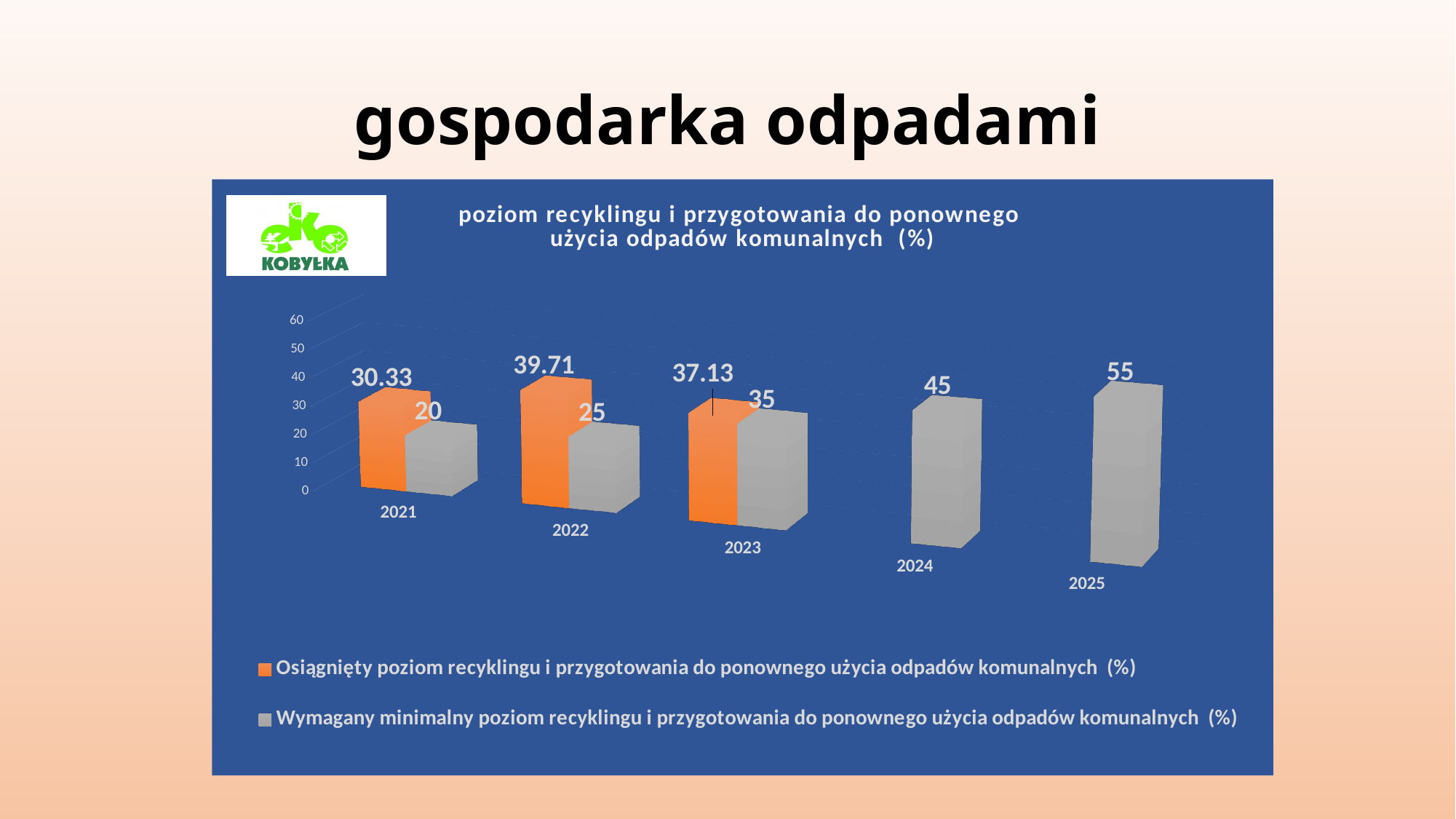
Which is larger in 2023: the achieved level or the required minimum level? the achieved level (37.13) What is the required minimum recycling level (Wymagany minimalny poziom) for 2025? 55 What is the achieved recycling level (Osiągnięty poziom) for 2022? 39.71 What is the difference between the achieved level and the required minimum level in 2021? 10.33 In which year is the required minimum recycling level (Wymagany minimalny poziom) the lowest? 2021 What is the required minimum recycling level (Wymagany minimalny poziom) for 2023? 35 How many years are shown on the x axis? 5 What kind of chart is shown? bar chart In which year is the achieved recycling level (Osiągnięty poziom) the highest? 2022 Does the required minimum recycling level rise or fall from 2021 to 2025? rise What is the achieved recycling level (Osiągnięty poziom) for 2021? 30.33 How many series does the legend list? 2